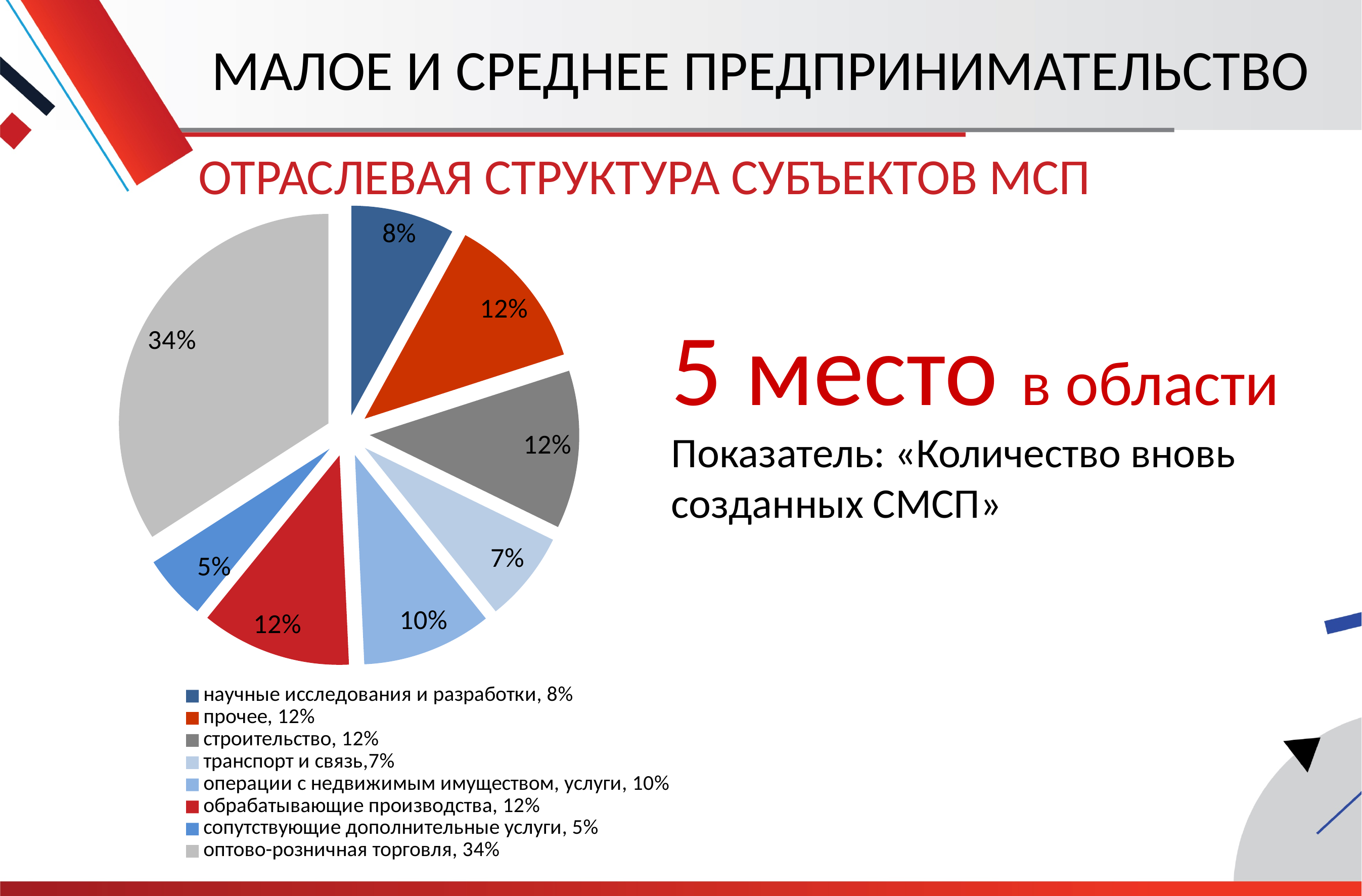
What is the difference between the shares of оптово-розничная торговля and строительство? 22% What is the share for научные исследования и разработки? 8% Which category has the smallest share of the pie? сопутствующие дополнительные услуги What type of chart is shown on the slide? pie chart How many categories does the pie chart have? 8 Which is larger: the share of операции с недвижимым имуществом, услуги or транспорт и связь? операции с недвижимым имуществом, услуги What is the title of the chart? ОТРАСЛЕВАЯ СТРУКТУРА СУБЪЕКТОВ МСП What is the share for оптово-розничная торговля? 34% What is the share for сопутствующие дополнительные услуги? 5% Which category has the largest share of the pie? оптово-розничная торговля What is the share for операции с недвижимым имуществом, услуги? 10% What is the share for транспорт и связь? 7%